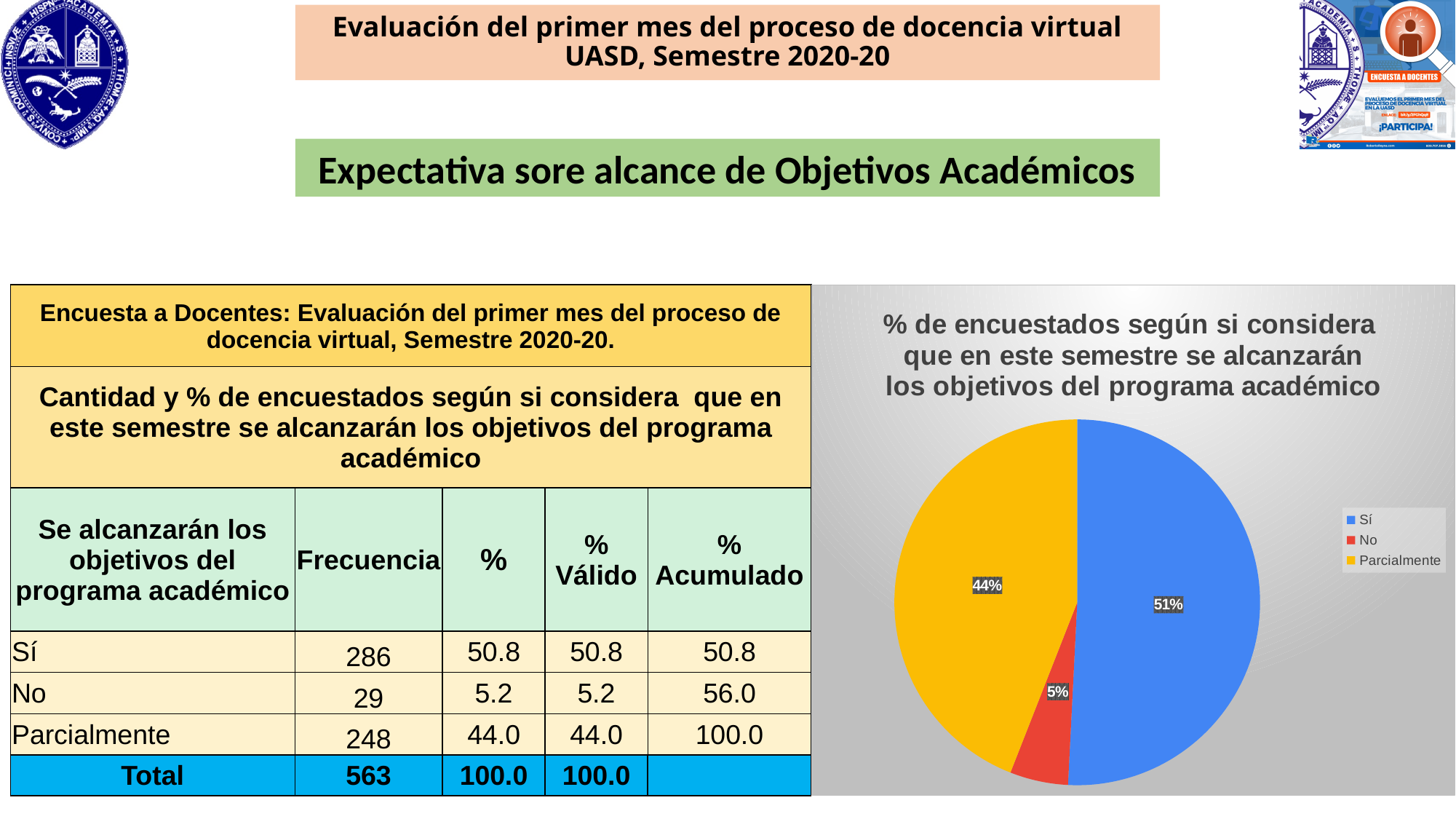
How many slices does the pie chart have? 3 What is the difference in percentage points between the "Sí" slice and the "Parcialmente" slice in the pie chart? 7 What percentage does the pie chart show for "No"? 5% What percentage does the pie chart show for "Sí"? 51% Which category has the smallest slice in the pie chart? No What is the difference in percentage points between the "Parcialmente" slice and the "No" slice in the pie chart? 39 What percentage does the pie chart show for "Parcialmente"? 44% What colour is the "Parcialmente" slice in the pie chart? yellow What type of chart is shown on the slide? pie chart How many entries does the pie chart's legend list? 3 Which category has the largest slice in the pie chart? Sí In the pie chart, which is larger: the slice for "Sí" or the slice for "Parcialmente"? Sí